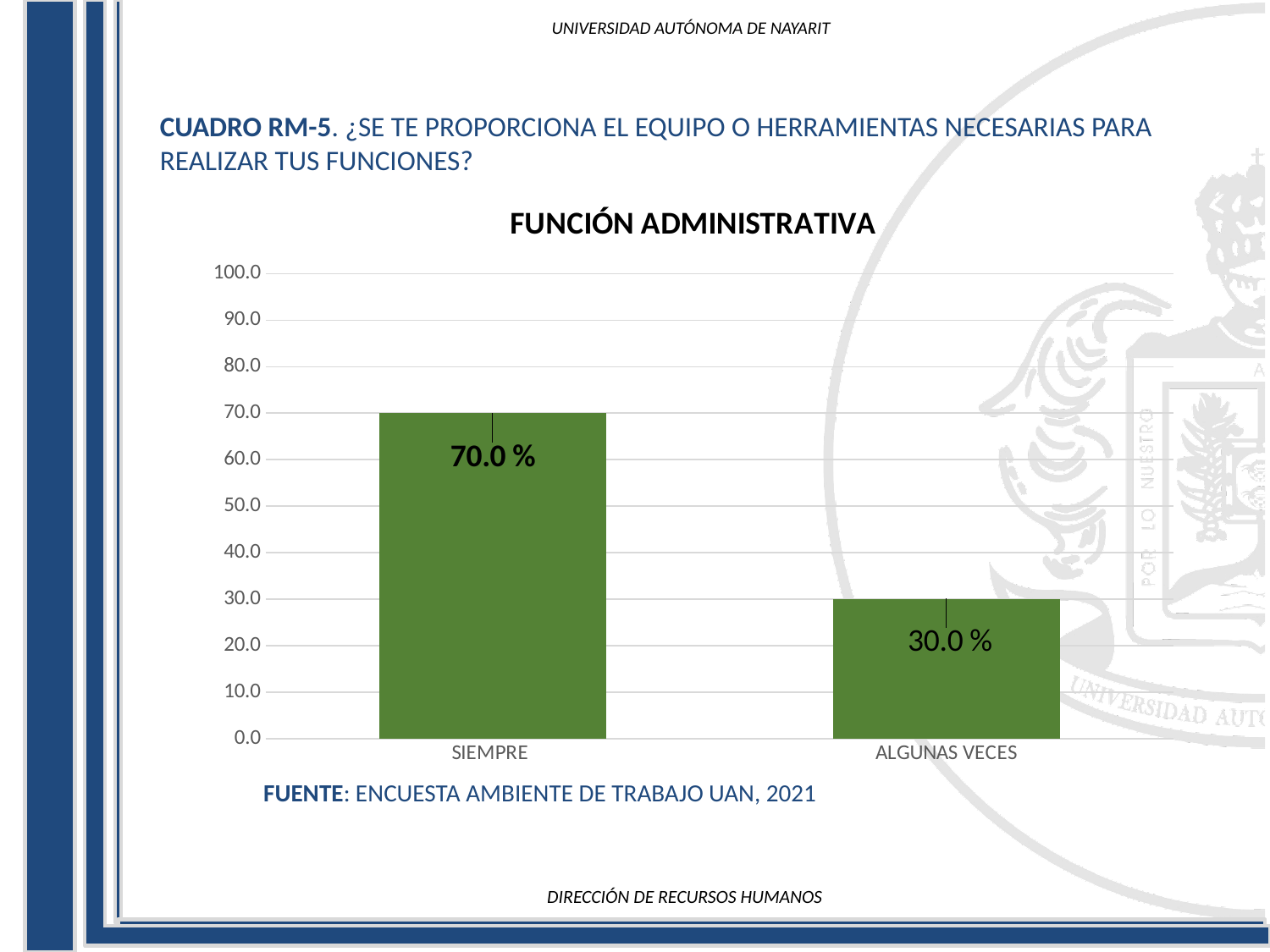
What is the highest value shown on the y axis? 100.0 Is the value for ALGUNAS VECES greater or less than 50.0? less What is the value for ALGUNAS VECES? 30.0 % Which is larger, the value for SIEMPRE or the value for ALGUNAS VECES? SIEMPRE Is the value for SIEMPRE greater or less than 60.0? greater What is the title of the chart? FUNCIÓN ADMINISTRATIVA What is the value for SIEMPRE? 70.0 % What is the difference between the values for SIEMPRE and ALGUNAS VECES? 40.0 % What kind of chart is shown on the slide? bar chart How many categories are shown on the x axis? 2 Which category has the lowest value? ALGUNAS VECES Which category has the highest value? SIEMPRE